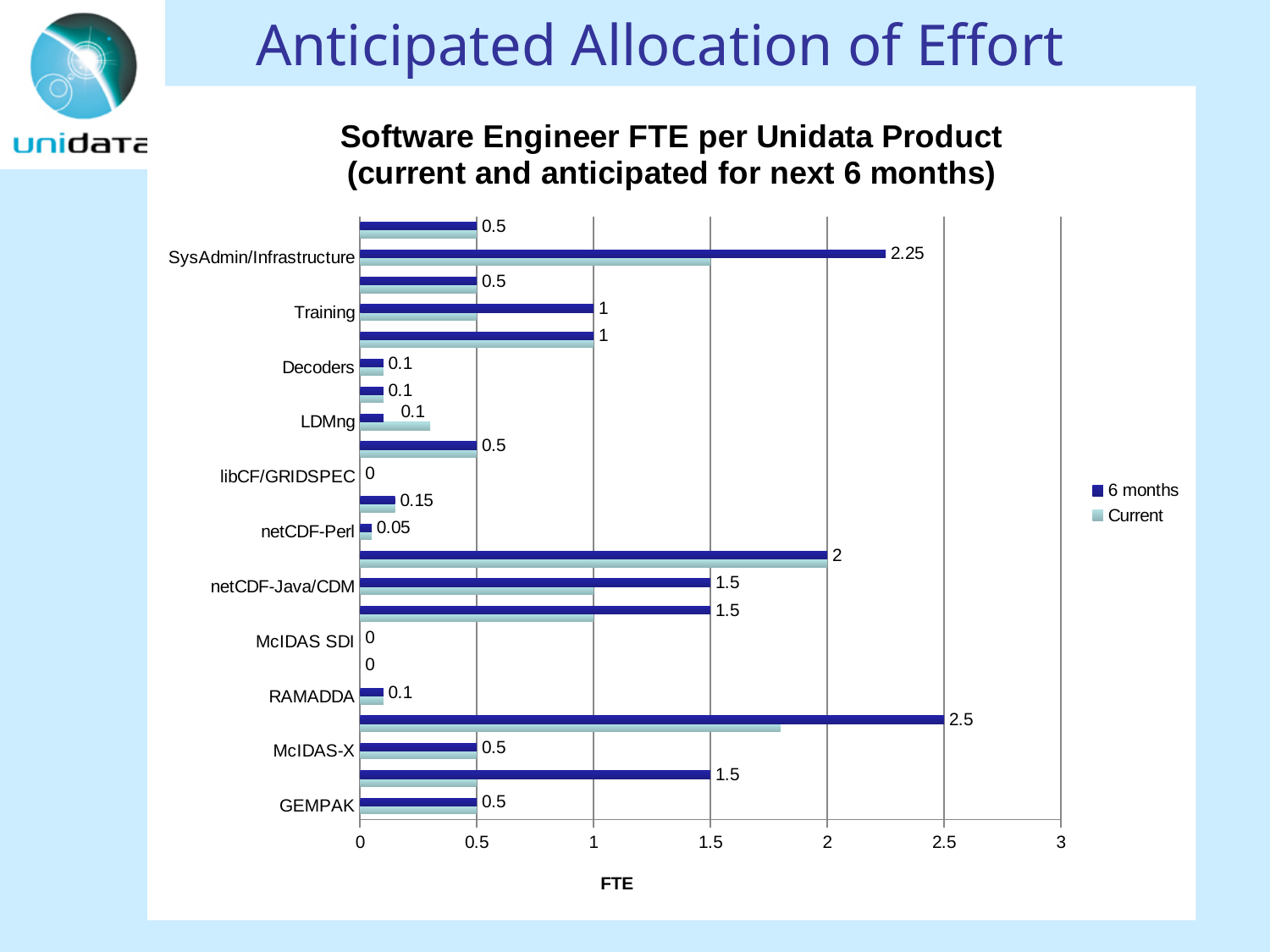
What is the 6 months value for GEMPAK? 0.5 What is the label on the horizontal axis of the chart? FTE How many series does the legend list? 2 What is the 6 months value for SysAdmin/Infrastructure? 2.25 Which has the larger 6 months value, Training or GEMPAK? Training What is the largest data label shown for the 6 months series? 2.5 What is the 6 months value for netCDF-Java/CDM? 1.5 What is the 6 months value for Training? 1 What kind of chart is shown on the slide? Bar chart What is the difference between the 6 months values for SysAdmin/Infrastructure and Training? 1.25 What is the 6 months value for netCDF-Perl? 0.05 Is the Current value for SysAdmin/Infrastructure greater or less than 1? greater